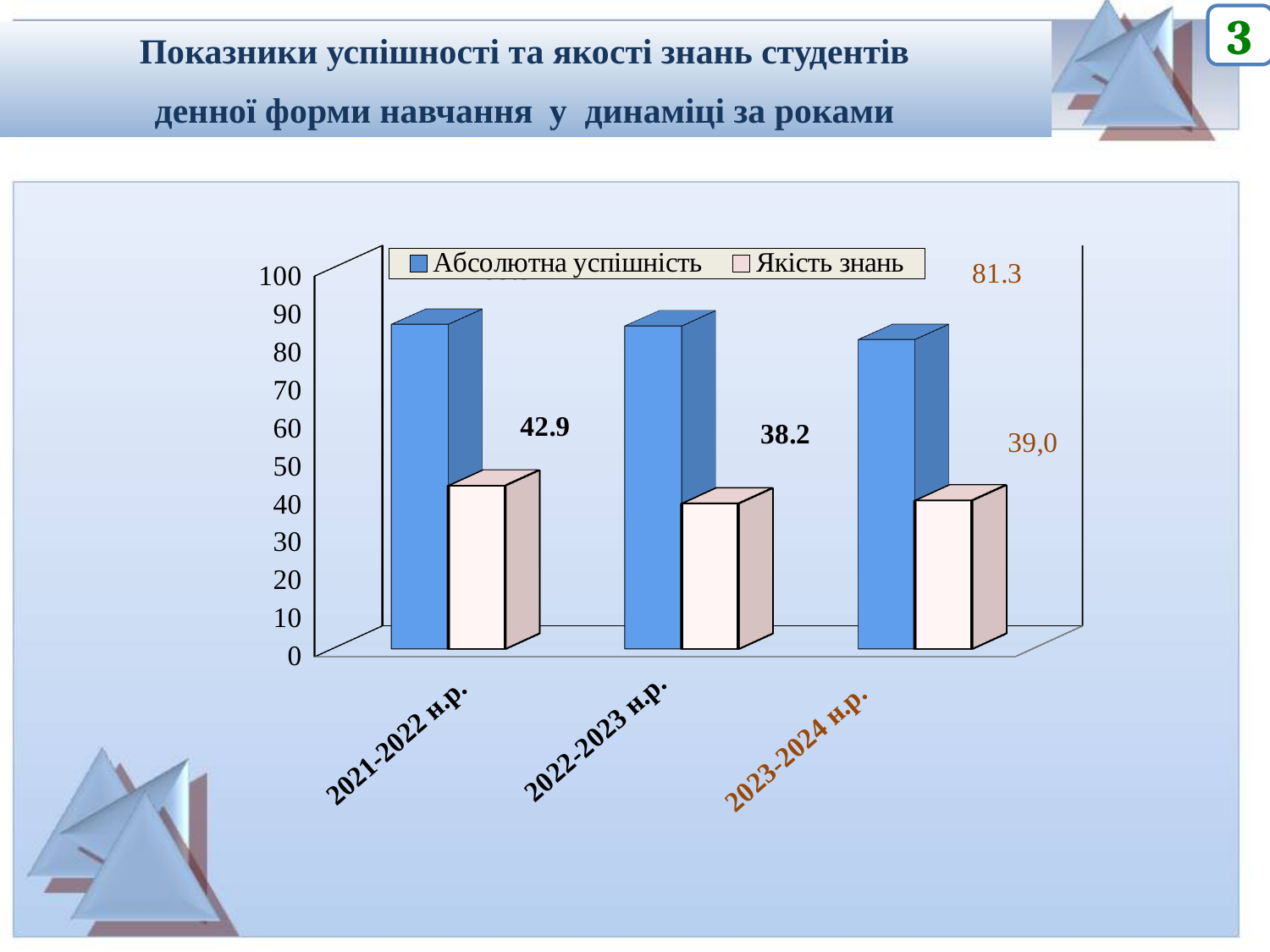
In which academic year is Якість знань the lowest? 2022-2023 н.р. Which is larger: Якість знань in 2022-2023 н.р. or in 2023-2024 н.р.? 2023-2024 н.р. What is the value of Якість знань for 2022-2023 н.р.? 38.2 How many series does the legend list? 2 What is the value of Абсолютна успішність for 2023-2024 н.р.? 81.3 In which academic year is Якість знань the highest? 2021-2022 н.р. What is the difference between Якість знань in 2021-2022 н.р. and 2022-2023 н.р.? 4.7 How many academic years are shown on the x axis? 3 Is the value of Абсолютна успішність for 2021-2022 н.р. greater or less than 80? greater Does Абсолютна успішність rise or fall across the academic years from 2021-2022 to 2023-2024? fall What is the value of Якість знань for 2021-2022 н.р.? 42.9 What is the value of Якість знань for 2023-2024 н.р.? 39,0